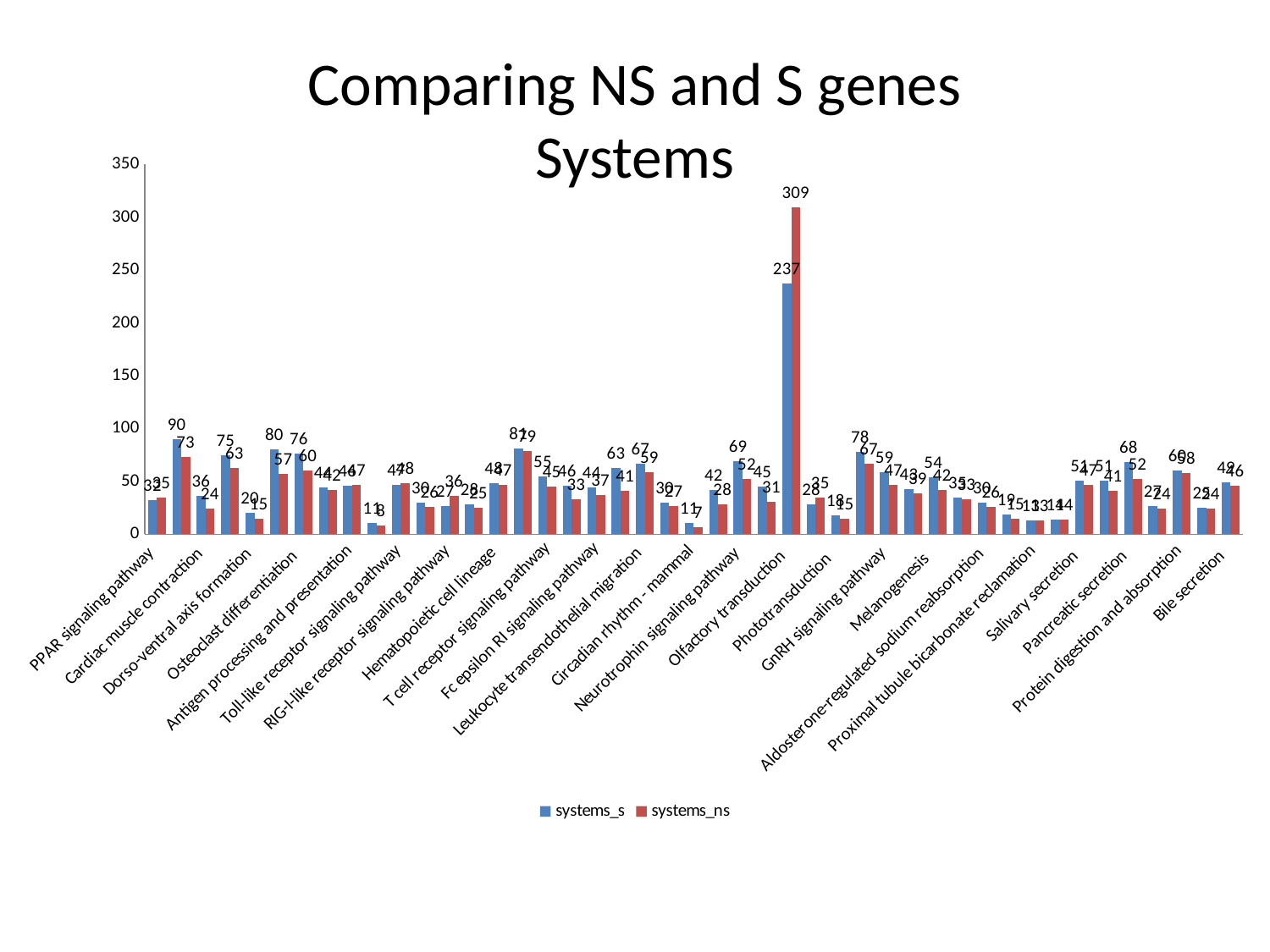
What is the systems_s value for Olfactory transduction? 237 What is the difference between the systems_ns and systems_s values for Olfactory transduction? 72 What is the systems_ns value for Olfactory transduction? 309 What is the highest value in the systems_s series? 237 How many series does the legend list? 2 Which category has the tallest bar on the chart? Olfactory transduction What is the highest value plotted on the chart? 309 For Olfactory transduction, which series has the larger value, systems_s or systems_ns? systems_ns What are the two series named in the legend? systems_s and systems_ns What kind of chart is shown on the slide? bar chart Is the systems_ns value for Olfactory transduction greater or less than 300? greater Which colour represents the systems_ns series? red